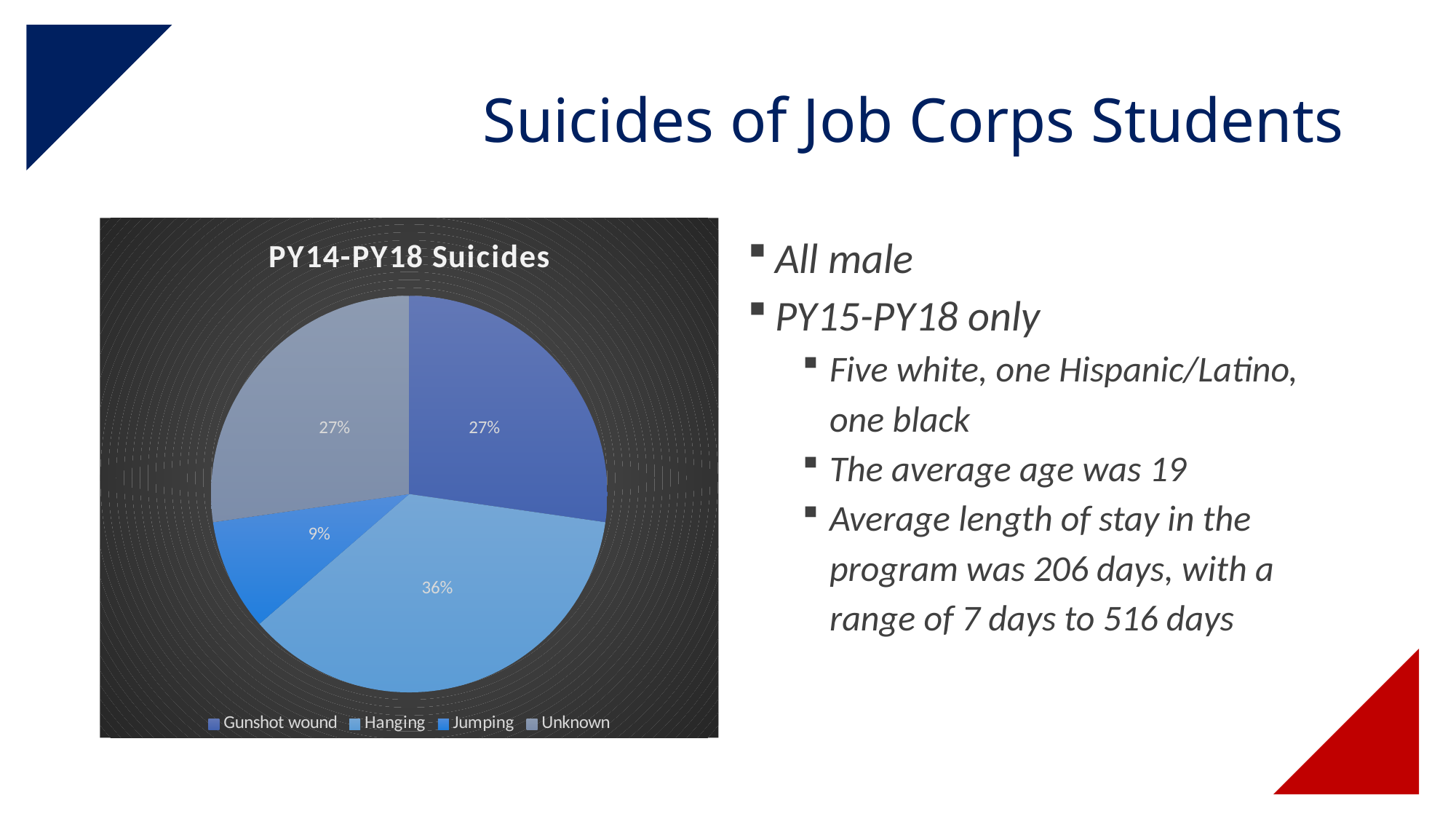
What is the combined share of Gunshot wound and Unknown? 54% What is the difference in percentage points between Hanging and Jumping? 27 What percentage of the pie is Unknown? 27% How many categories does the legend list? 4 What percentage of the pie is Jumping? 9% What is the title of the chart? PY14-PY18 Suicides What percentage of the pie is Gunshot wound? 27% Which category has the smallest share of the pie? Jumping What percentage of the pie is Hanging? 36% What kind of chart is shown on the slide? Pie chart Which category has the largest share of the pie? Hanging Which is larger, the share for Hanging or the share for Gunshot wound? Hanging